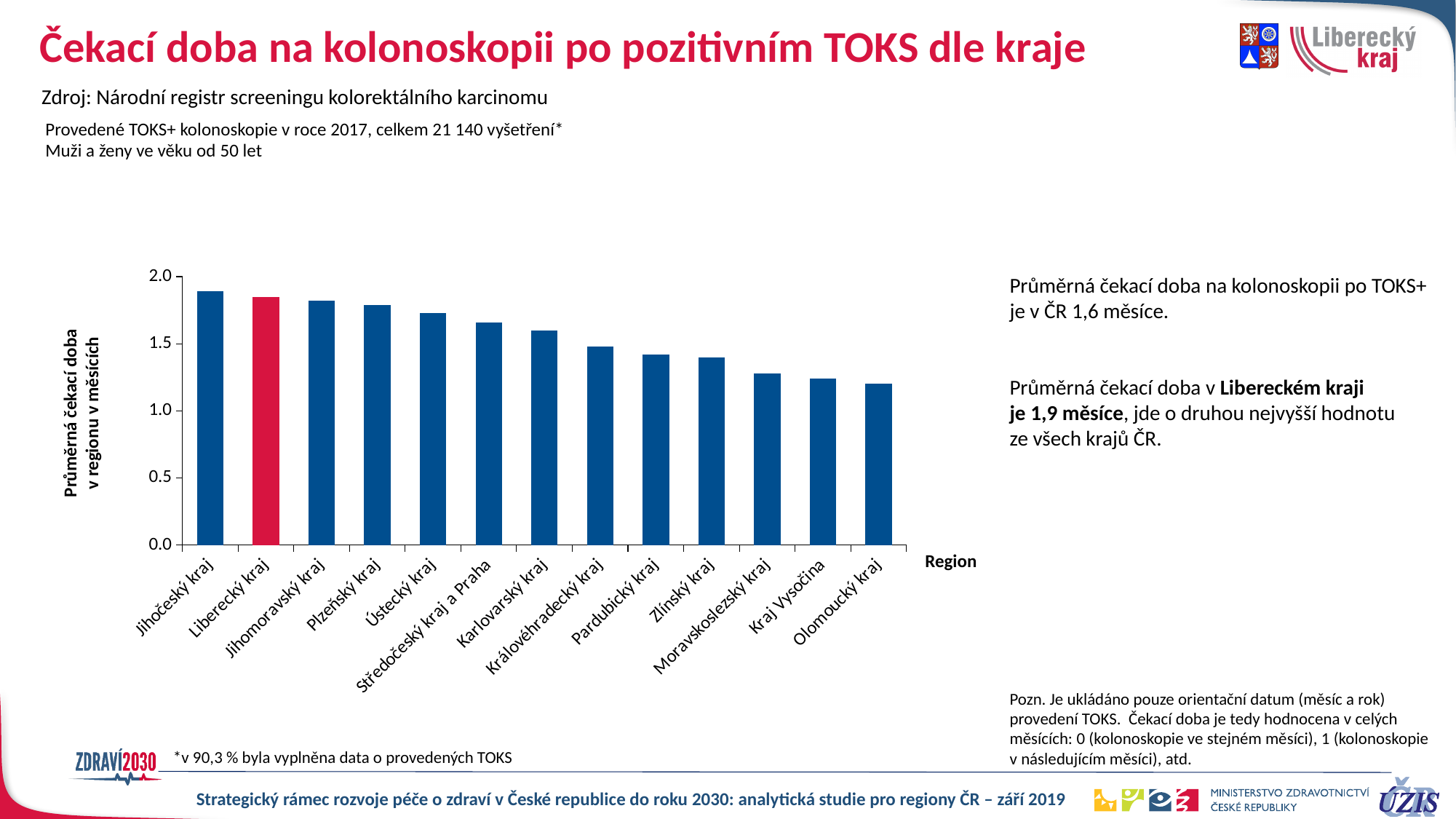
Which bar in the chart is highlighted in red? Liberecký kraj What is the label of the y axis of the chart? Průměrná čekací doba v regionu v měsících Do the values rise or fall from left to right along the x axis? fall Is the value for Pardubický kraj greater or less than 1.5? less How many regions are plotted on the x axis of the chart? 13 Is the value for Jihočeský kraj greater or less than 1.5? greater What kind of chart is shown on the slide? bar chart Which region has the highest average waiting time in the chart? Jihočeský kraj Is the value for Moravskoslezský kraj greater or less than 1.0? greater Which region has a larger value, Plzeňský kraj or Zlínský kraj? Plzeňský kraj Which region has the lowest average waiting time in the chart? Olomoucký kraj